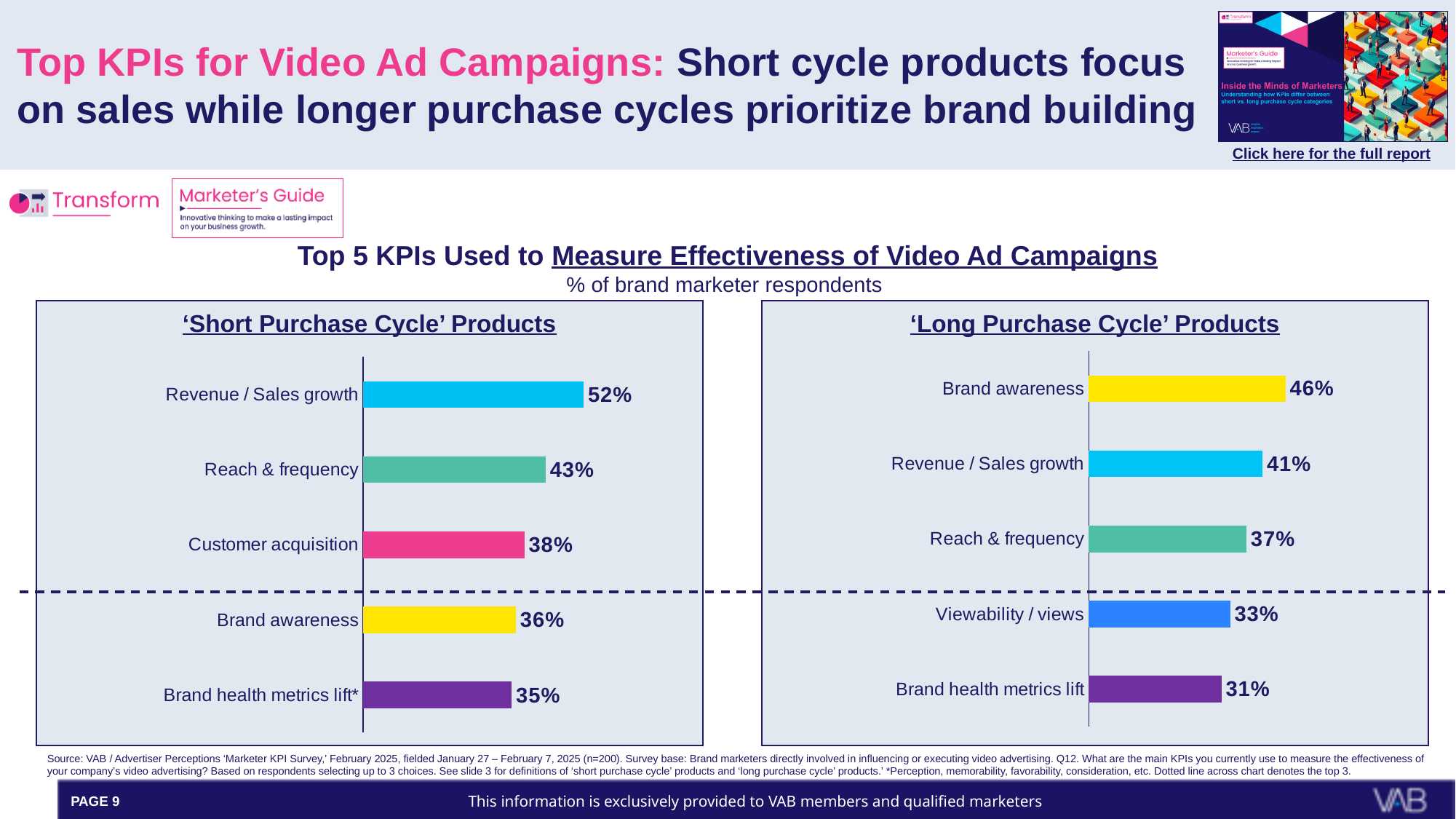
In the 'Short Purchase Cycle' Products chart, which KPI has the highest value? Revenue / Sales growth In the 'Long Purchase Cycle' Products chart, which KPI has the lowest value? Brand health metrics lift In the 'Long Purchase Cycle' Products chart, what is the difference between Brand awareness and Revenue / Sales growth? 5 percentage points In the 'Short Purchase Cycle' Products chart, what percentage of respondents cited Revenue / Sales growth? 52% In the 'Short Purchase Cycle' Products chart, what is the value for Customer acquisition? 38% In the 'Long Purchase Cycle' Products chart, what is the value for Viewability / views? 33% Which is larger: Reach & frequency in the 'Short Purchase Cycle' chart or Reach & frequency in the 'Long Purchase Cycle' chart? Short Purchase Cycle (43%) According to the footnote, what does the dotted line across the charts denote? The top 3 In the 'Long Purchase Cycle' Products chart, what is the value for Brand awareness? 46% How many KPIs are shown in the 'Long Purchase Cycle' Products chart? 5 What type of chart is used for the 'Short Purchase Cycle' Products data? Bar chart In the 'Short Purchase Cycle' Products chart, what is the difference between Revenue / Sales growth and Brand awareness? 16 percentage points